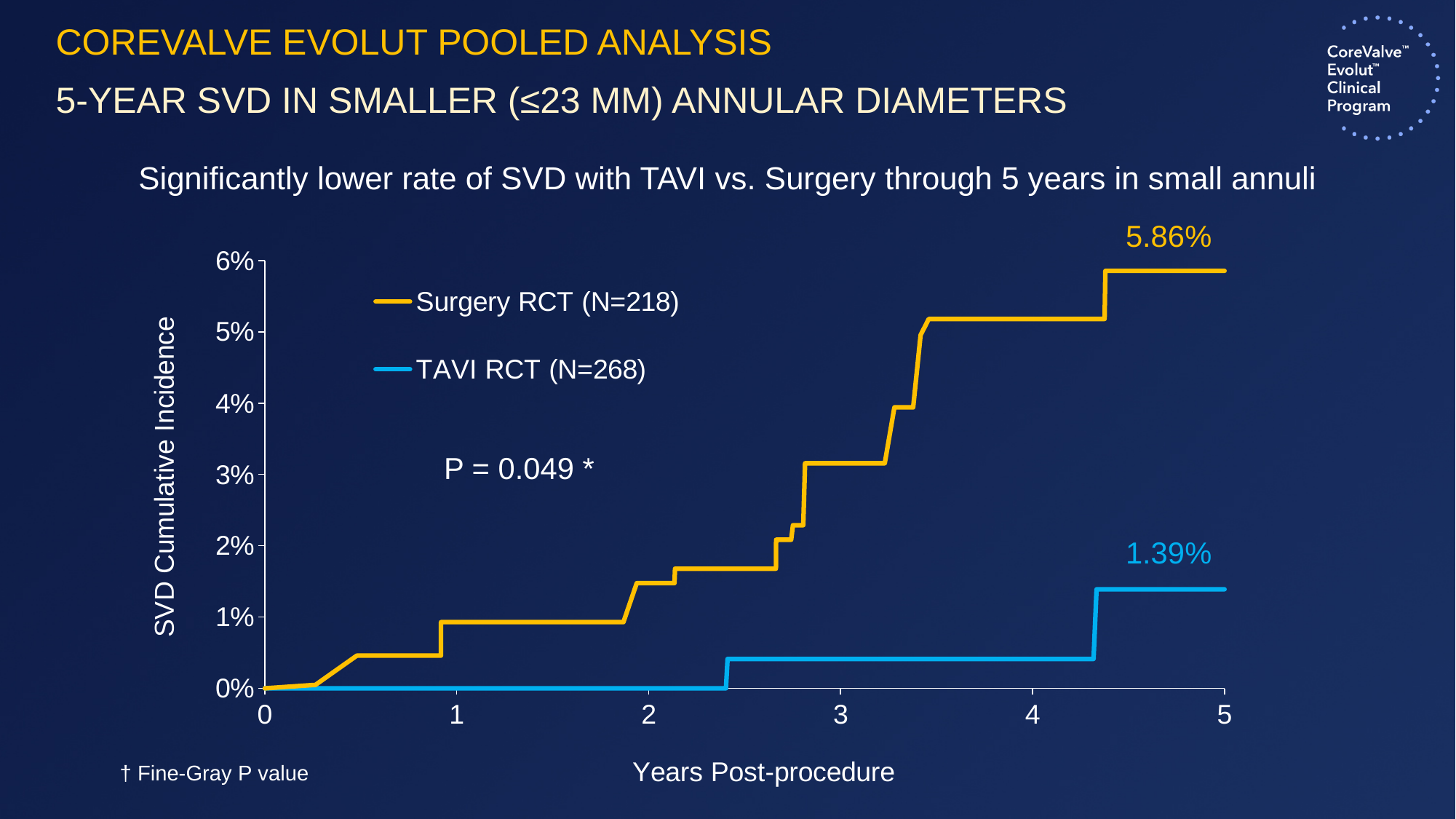
What is the difference between the Surgery RCT and TAVI RCT SVD cumulative incidence at 5 years? 4.47% How many patients are in the TAVI RCT group according to the legend? 268 Do the SVD cumulative incidence values rise or fall over the years post-procedure? Rise Which group has the lower SVD cumulative incidence at 5 years? TAVI RCT What is the 5-year SVD cumulative incidence for the TAVI RCT group? 1.39% How many series does the legend list? 2 What is the 5-year SVD cumulative incidence for the Surgery RCT group? 5.86% Which group has the higher SVD cumulative incidence at 5 years? Surgery RCT Is the Surgery RCT SVD cumulative incidence at 3 years greater or less than 2%? greater What is the P value shown on the chart? P = 0.049 What kind of chart is shown on the slide? Line chart (cumulative incidence curve) Is the TAVI RCT SVD cumulative incidence at 3 years greater or less than 1%? less